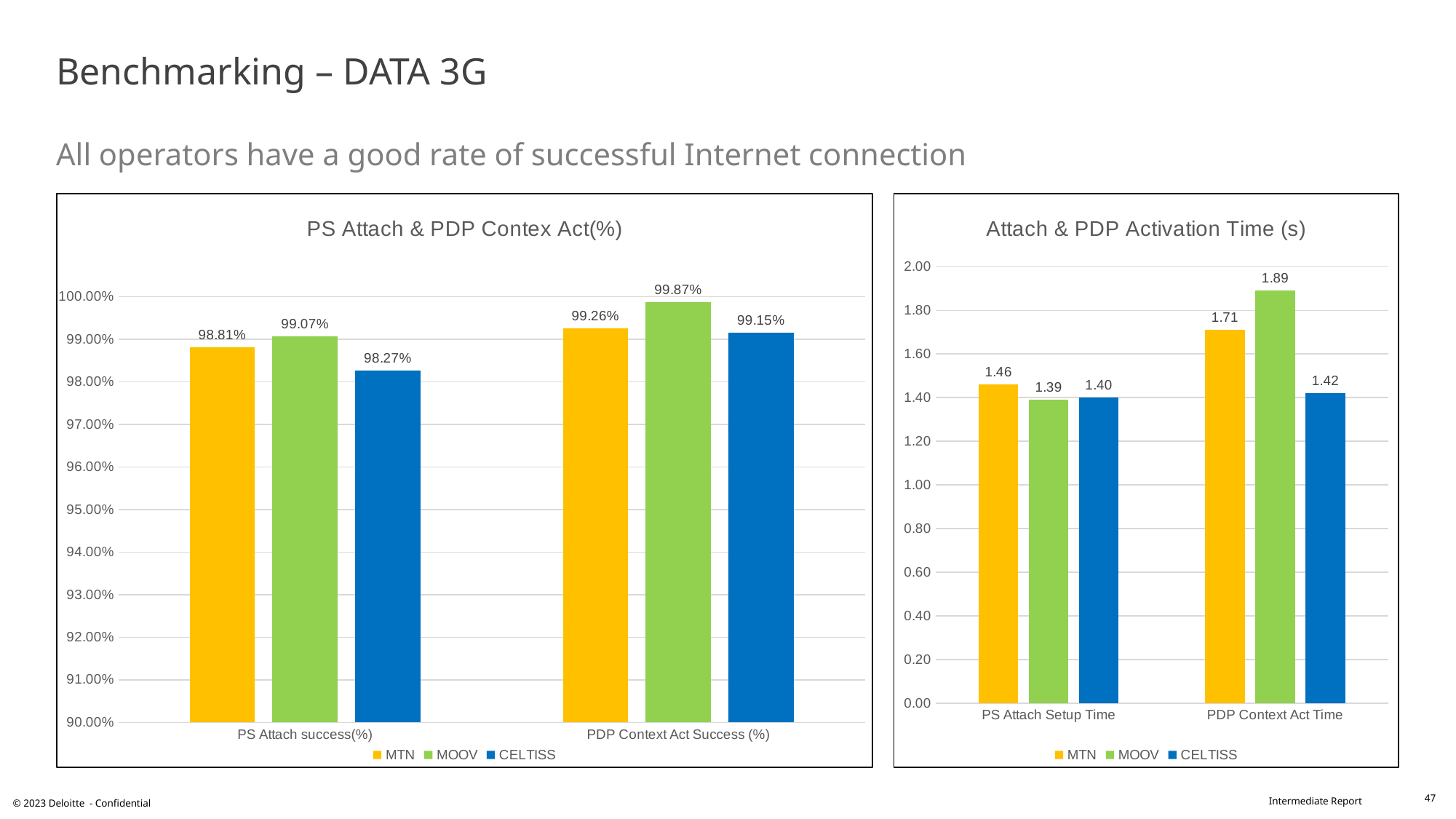
In the 'PS Attach & PDP Contex Act(%)' chart, which operator has the lowest PS Attach success(%)? CELTISS In the 'Attach & PDP Activation Time (s)' chart, which operator has the highest PDP Context Act Time? MOOV In the 'Attach & PDP Activation Time (s)' chart, what is the PDP Context Act Time for MTN? 1.71 In the 'PS Attach & PDP Contex Act(%)' chart, which operator has the highest PDP Context Act Success (%)? MOOV In the 'PS Attach & PDP Contex Act(%)' chart, what is the PDP Context Act Success (%) value for CELTISS? 99.15% How many series does the legend of the 'Attach & PDP Activation Time (s)' chart list? 3 In the 'PS Attach & PDP Contex Act(%)' chart, what is the PS Attach success(%) value for MOOV? 99.07% What type of chart is the 'PS Attach & PDP Contex Act(%)' chart? bar chart In the 'Attach & PDP Activation Time (s)' chart, is MTN's PS Attach Setup Time larger or smaller than CELTISS's? larger In the 'PS Attach & PDP Contex Act(%)' chart, what is the difference between MOOV's and CELTISS's PS Attach success(%)? 0.80% In the 'Attach & PDP Activation Time (s)' chart, what is the difference between MOOV's and CELTISS's PDP Context Act Time? 0.47 In the 'Attach & PDP Activation Time (s)' chart, which operator has the lowest PS Attach Setup Time? MOOV